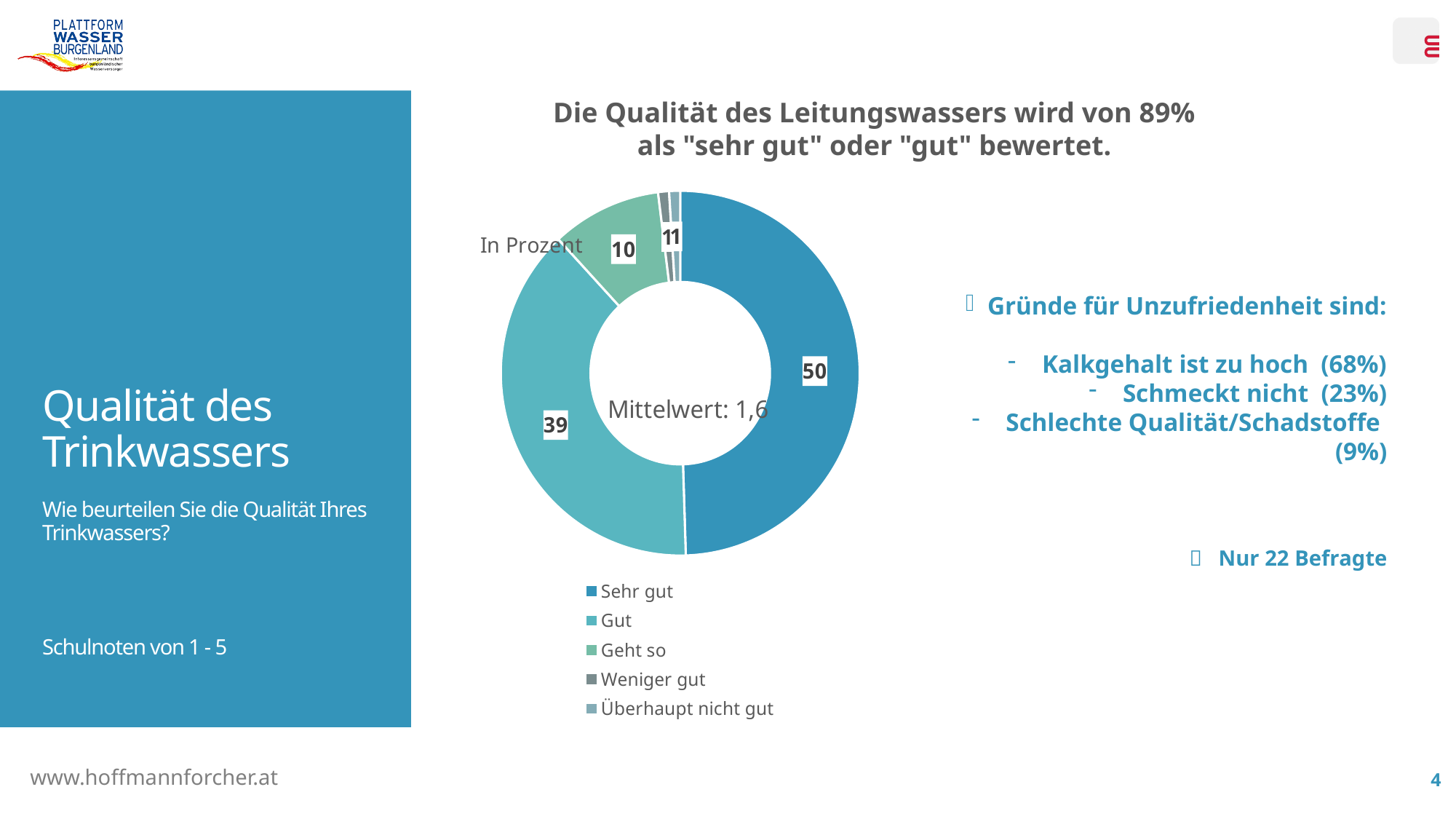
What unit does the chart state its values are in? In Prozent What is the difference between the values for "Gut" and "Geht so"? 29 How many categories does the legend of the chart list? 5 What percentage of respondents rated their drinking water quality as "Sehr gut"? 50 What value is shown for the "Gut" category? 39 What kind of chart is shown on the slide? Doughnut chart Which is larger, the value for "Gut" or the value for "Geht so"? Gut What is the combined value of "Sehr gut" and "Gut"? 89 What is the Mittelwert (mean value) shown in the centre of the chart? 1,6 What is the difference between the values for "Sehr gut" and "Gut"? 11 What value is shown for the "Geht so" category? 10 Which category has the largest share of the doughnut chart? Sehr gut